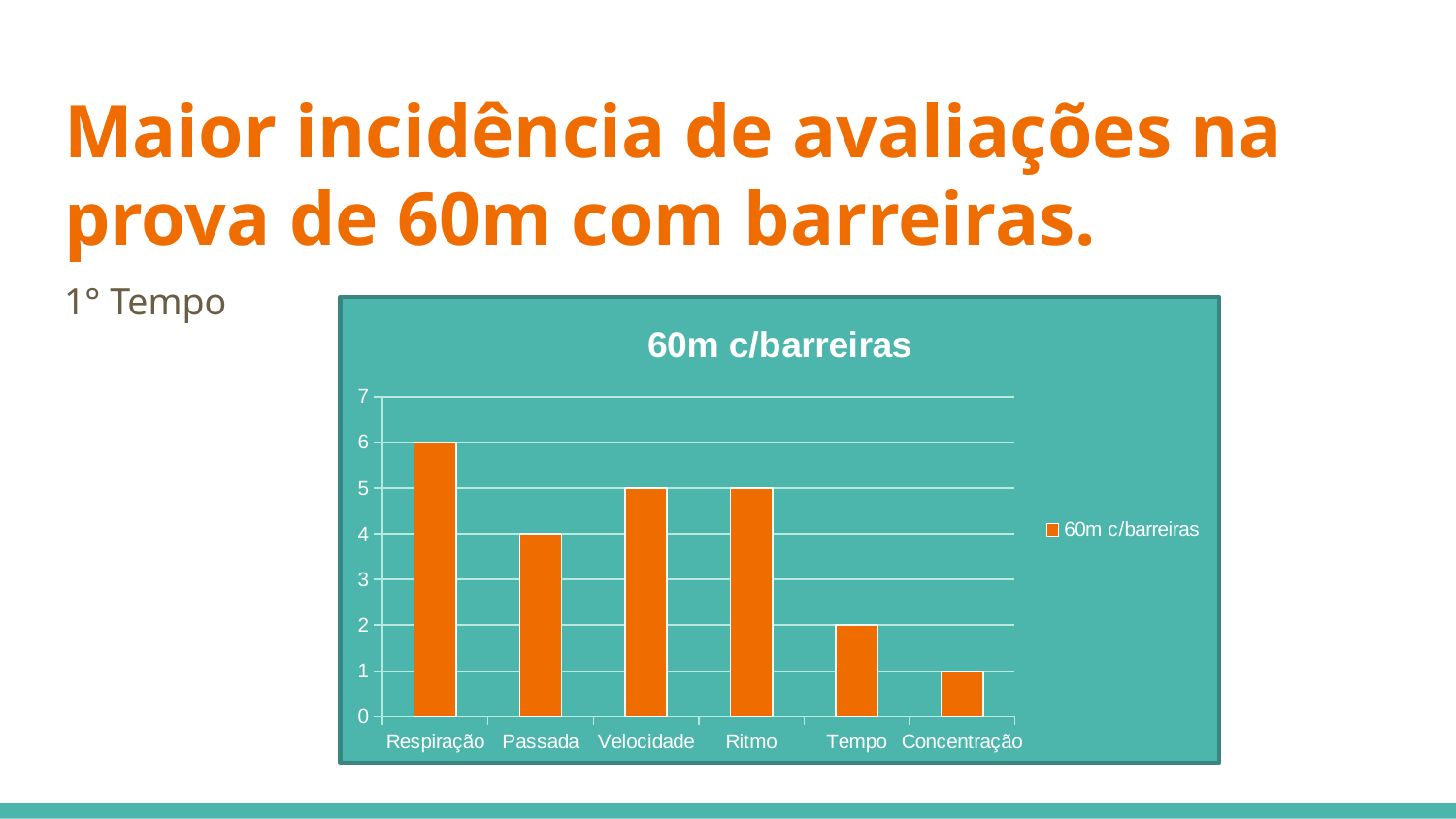
What is the difference between the values for Respiração and Concentração? 5 What is the value for Respiração? 6 Is the value for Velocidade greater or less than 3? greater How many categories are shown on the x axis of the chart? 6 Which is larger, the value for Passada or the value for Tempo? Passada What is the value for Passada? 4 Which category has the highest value? Respiração What kind of chart is shown on the slide? bar chart What is the title of the chart? 60m c/barreiras Which category has the lowest value? Concentração How many series does the legend list? 1 What is the value for Tempo? 2